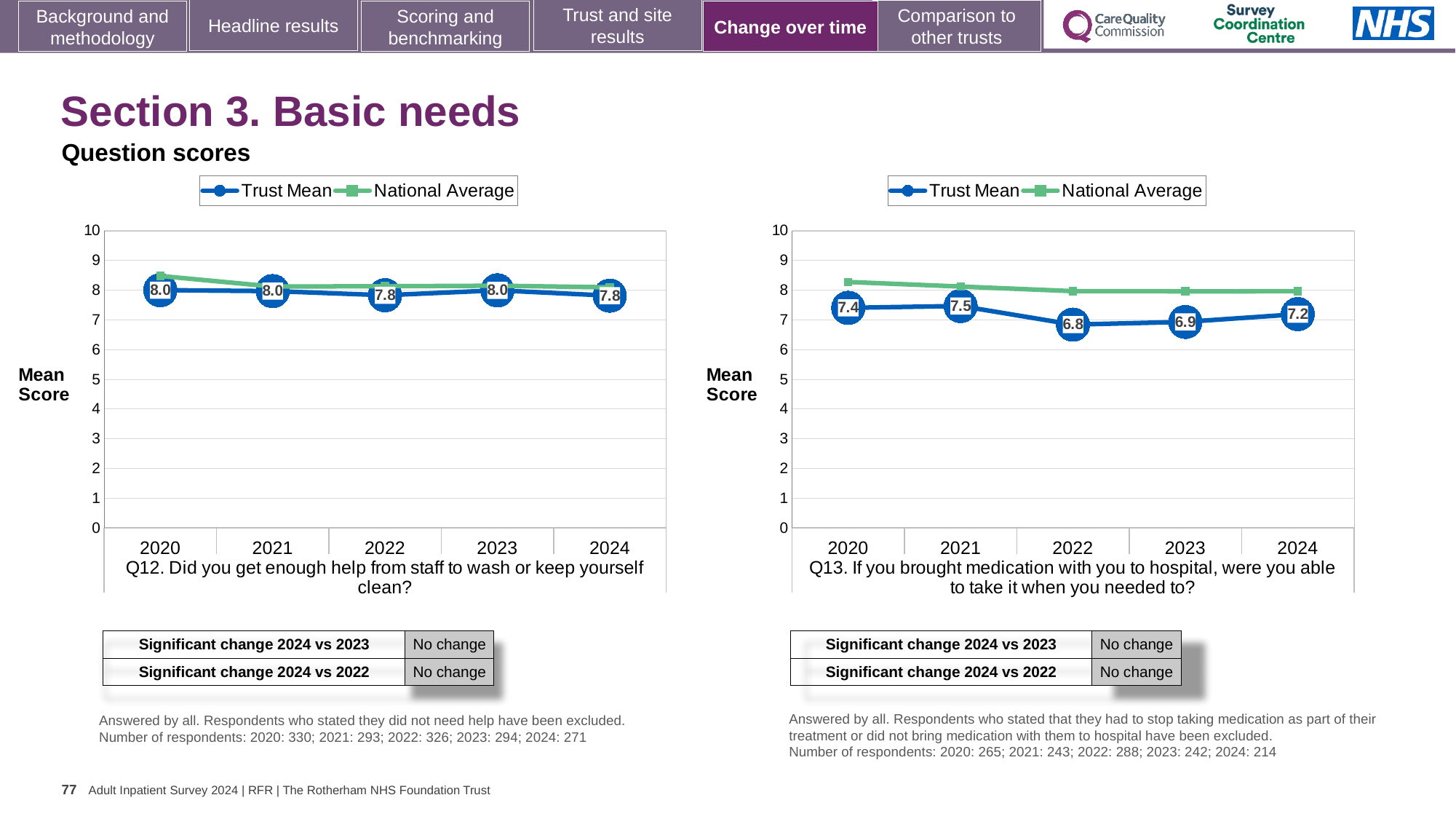
On the Q12 chart (left), what is the Trust Mean for 2020? 8.0 On the Q13 chart (right), what is the Trust Mean for 2022? 6.8 On the Q13 chart (right), which year has the highest Trust Mean? 2021 On the Q13 chart (right), what is the difference between the Trust Mean for 2021 and 2022? 0.7 On the Q13 chart (right), what is the Trust Mean for 2024? 7.2 What type of chart is the Q12 chart (left)? Line chart On the Q13 chart (right), is the National Average for 2020 greater or less than 8? greater On the Q12 chart (left), is the Trust Mean for 2023 larger or smaller than the Trust Mean for 2024? larger On the Q13 chart (right), which year has the lowest Trust Mean? 2022 How many series does the legend of the Q13 chart (right) list? 2 On the Q12 chart (left), what is the Trust Mean for 2022? 7.8 How many years are plotted on the Q12 chart (left)? 5